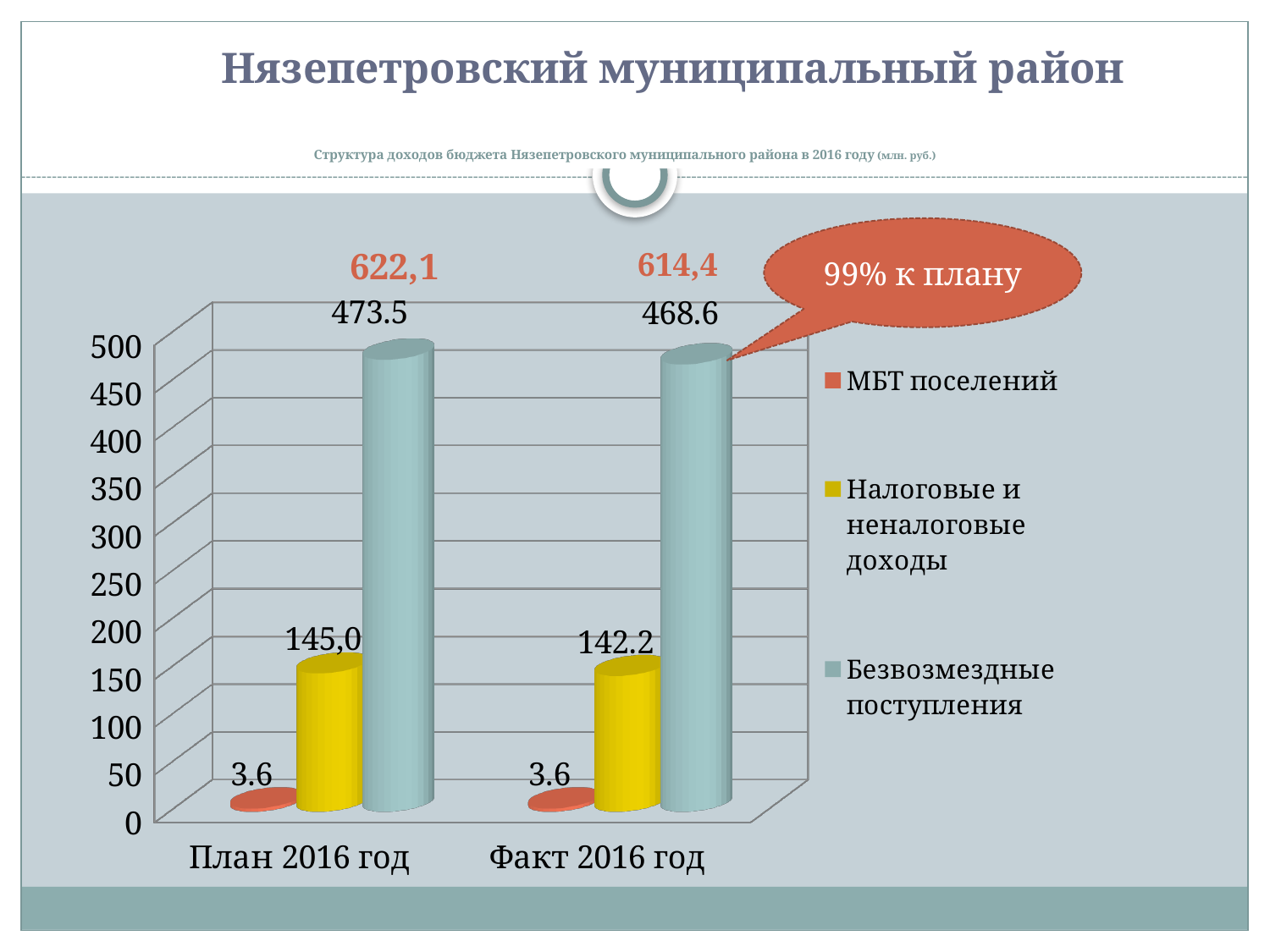
What is the value of Безвозмездные поступления for План 2016 год? 473.5 What is the difference between Безвозмездные поступления for План 2016 год and for Факт 2016 год? 4.9 What is the value of Налоговые и неналоговые доходы for Факт 2016 год? 142.2 How many series does the legend list? 3 Which is larger: Налоговые и неналоговые доходы for План 2016 год or for Факт 2016 год? План 2016 год What is the value of МБТ поселений for Факт 2016 год? 3.6 What is the value of Налоговые и неналоговые доходы for План 2016 год? 145,0 Which series has the highest value for План 2016 год? Безвозмездные поступления What total is printed above the Факт 2016 год group of bars? 614,4 What kind of chart is shown on the slide? Bar chart Which series has the lowest value for Факт 2016 год? МБТ поселений What is the value of Безвозмездные поступления for Факт 2016 год? 468.6